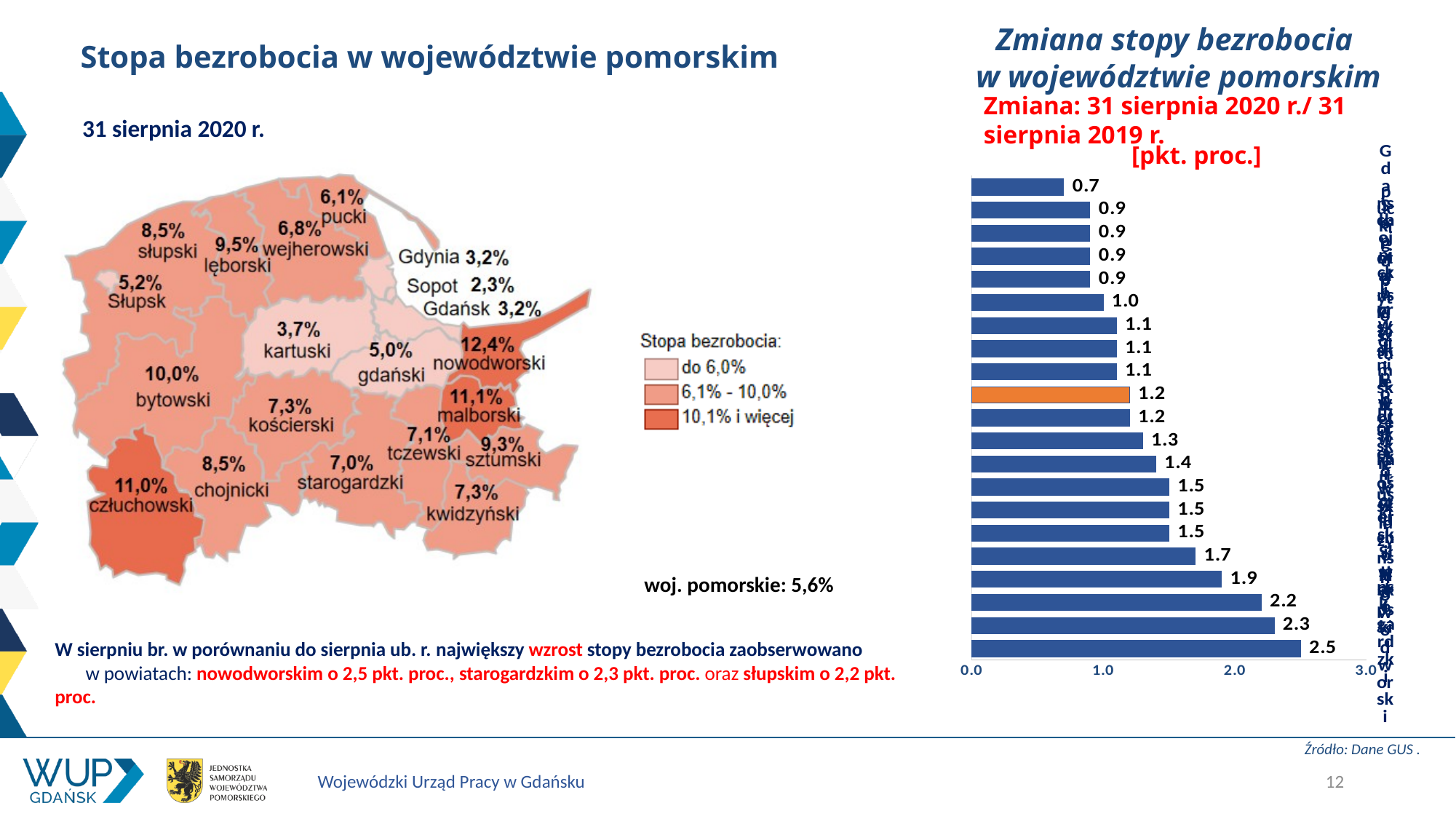
In the bar chart on the right, what is the difference between the largest value (2.5) and the smallest value (0.7)? 1.8 In the bar chart on the right, how many bars have the value 1.5? 3 What kind of chart is shown on the right side of the slide under the title 'Zmiana stopy bezrobocia w województwie pomorskim'? bar chart On the map on the left, what unemployment rate is shown for the nowodworski district? 12,4% In the bar chart on the right, how many bars have the value 0.9? 4 In the bar chart on the right, what unit is given in red above the bars? [pkt. proc.] In the bar chart on the right, what is the largest value shown? 2.5 In the bar chart on the right, how many bars are plotted? 21 In the bar chart on the right, what value is labelled on the orange bar? 1.2 In the bar chart on the right, what is the highest tick value shown on the horizontal axis? 3.0 In the bar chart on the right, what is the smallest value shown? 0.7 On the map on the left, which of the two has the higher unemployment rate: kartuski or bytowski? bytowski